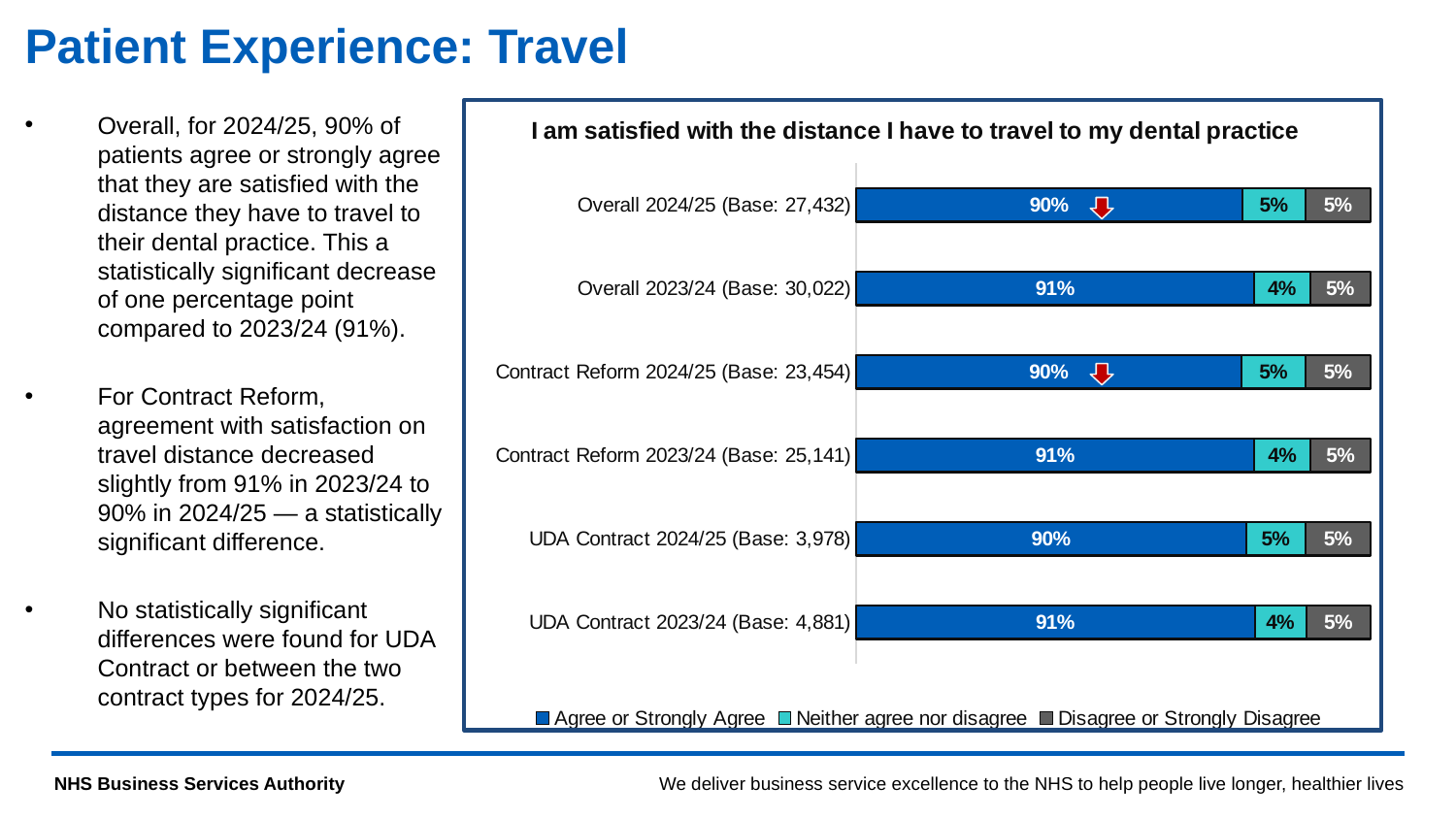
Which is larger: the 'Neither agree nor disagree' value for UDA Contract 2024/25 or for UDA Contract 2023/24? UDA Contract 2024/25 What is the title of the chart? I am satisfied with the distance I have to travel to my dental practice What percentage of patients agree or strongly agree for Overall 2024/25? 90% What is the total of the three segments for the Contract Reform 2024/25 bar? 100% What is the 'Neither agree nor disagree' value for Overall 2023/24? 4% How many series does the legend list? 3 What kind of chart is shown on the slide? Stacked bar chart What is the difference in 'Agree or Strongly Agree' between Overall 2023/24 and Overall 2024/25? 1% What is the 'Agree or Strongly Agree' value for Contract Reform 2023/24? 91% What is the 'Disagree or Strongly Disagree' value for UDA Contract 2024/25? 5% What is the base (number of respondents) shown for Overall 2024/25? 27,432 How many categories (bars) are shown in the chart? 6